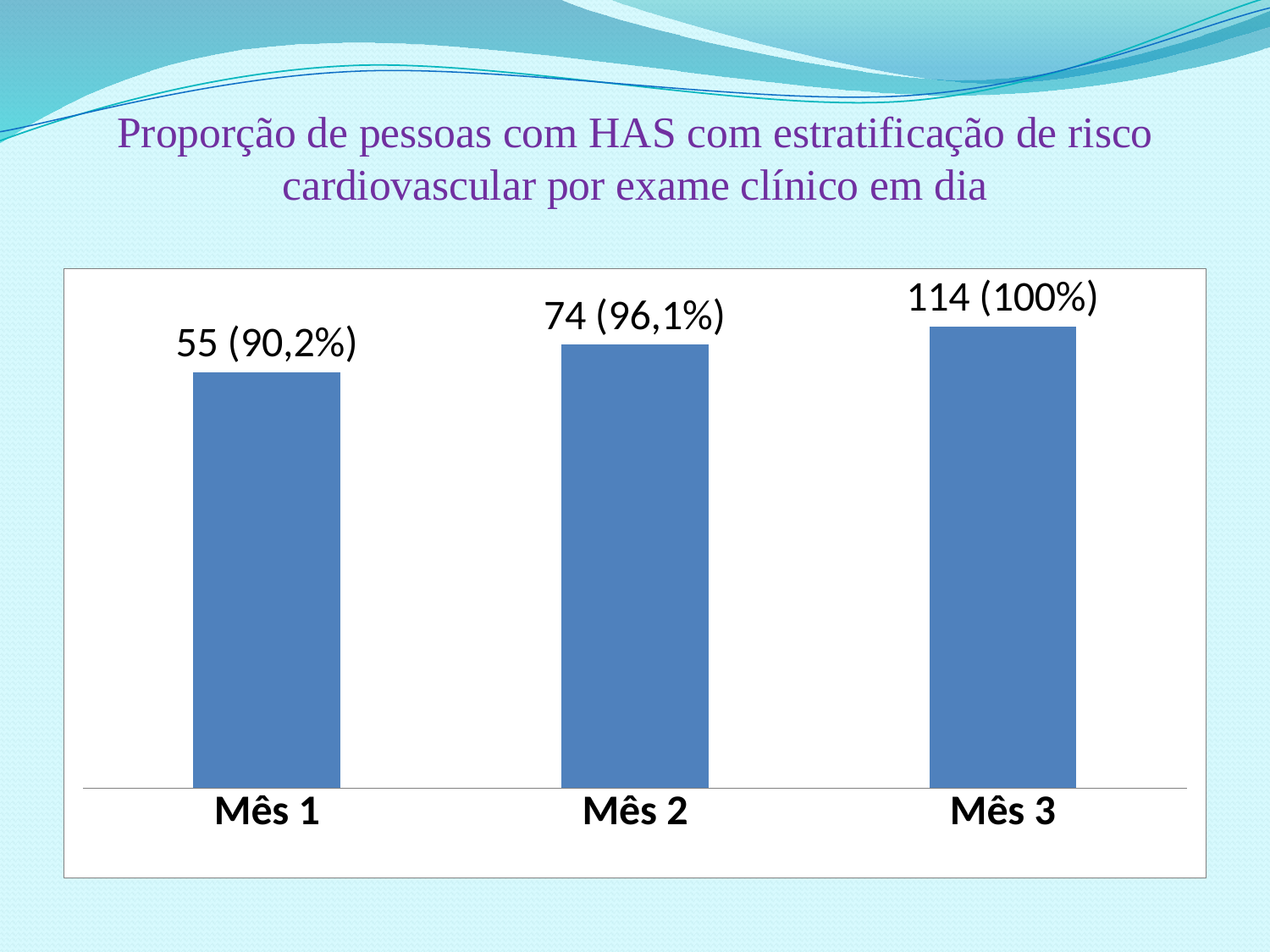
Which month has the lowest percentage? Mês 1 What is the data label shown for Mês 1? 55 (90,2%) What kind of chart is shown on the slide? Bar chart Do the percentages rise or fall from Mês 1 to Mês 3? Rise Which has a higher percentage, Mês 1 or Mês 2? Mês 2 Which month has the highest percentage? Mês 3 How many months (categories) are shown on the chart? 3 What is the difference in percentage points between Mês 3 and Mês 1? 9,8 What is the data label shown for Mês 3? 114 (100%) What is the difference between the counts shown for Mês 3 and Mês 2? 40 What is the data label shown for Mês 2? 74 (96,1%) What percentage is shown for Mês 2? 96,1%